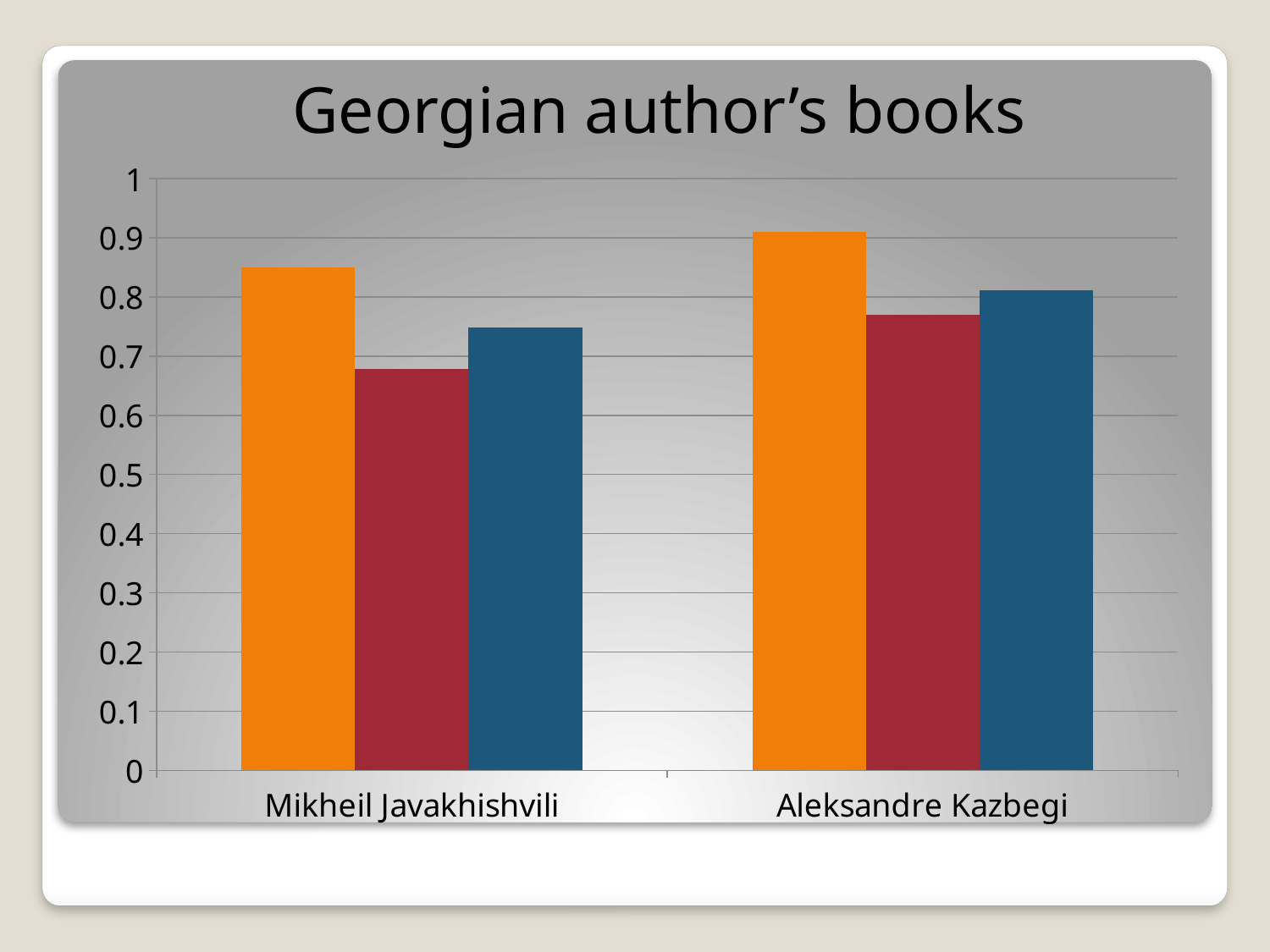
What is the title of the chart? Georgian author's books Which author has the tallest bar in the chart? Aleksandre Kazbegi Is the red bar for Mikheil Javakhishvili greater or less than 0.8? less Is the red bar for Aleksandre Kazbegi greater or less than 0.8? less Which author has the larger blue bar, Mikheil Javakhishvili or Aleksandre Kazbegi? Aleksandre Kazbegi How many authors (categories) are shown on the x axis? 2 What kind of chart is shown on the slide? bar chart Is the orange bar for Mikheil Javakhishvili greater or less than 0.8? greater For Mikheil Javakhishvili, which is larger, the orange bar or the red bar? the orange bar How many bars are plotted for each author? 3